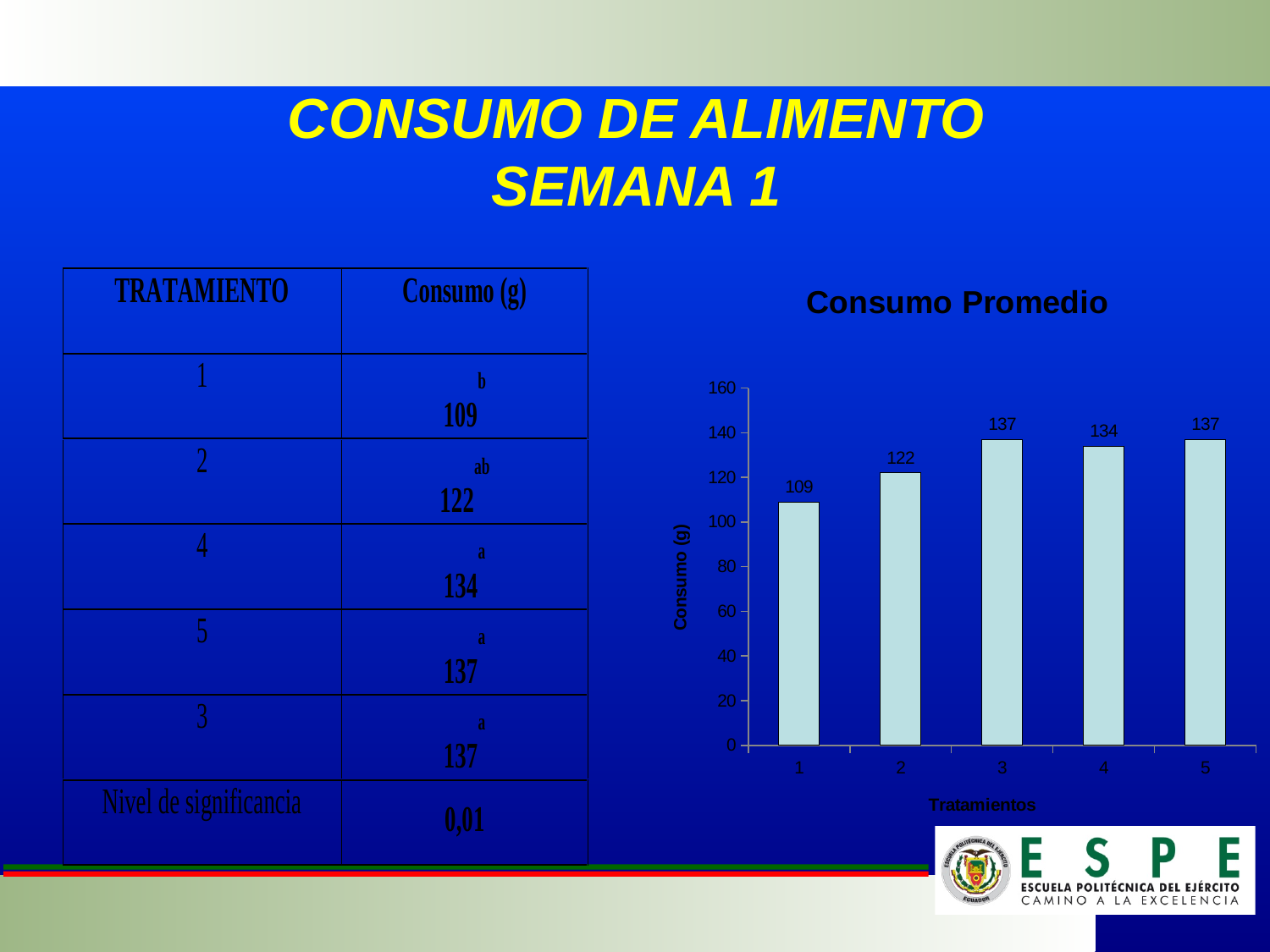
What is the difference between the values for treatment 3 and treatment 1? 28 What is the value for treatment 1 in the chart? 109 What is the label of the y axis of the chart? Consumo (g) What is the title of the chart? Consumo Promedio What type of chart is shown on the slide? bar chart Which has a larger value, treatment 2 or treatment 4? treatment 4 How many treatments are plotted in the chart? 5 What is the value for treatment 5 in the chart? 137 Is the value for treatment 1 greater or less than 120? less What is the value for treatment 2 in the chart? 122 What is the value for treatment 4 in the chart? 134 Which treatment has the lowest value in the chart? 1